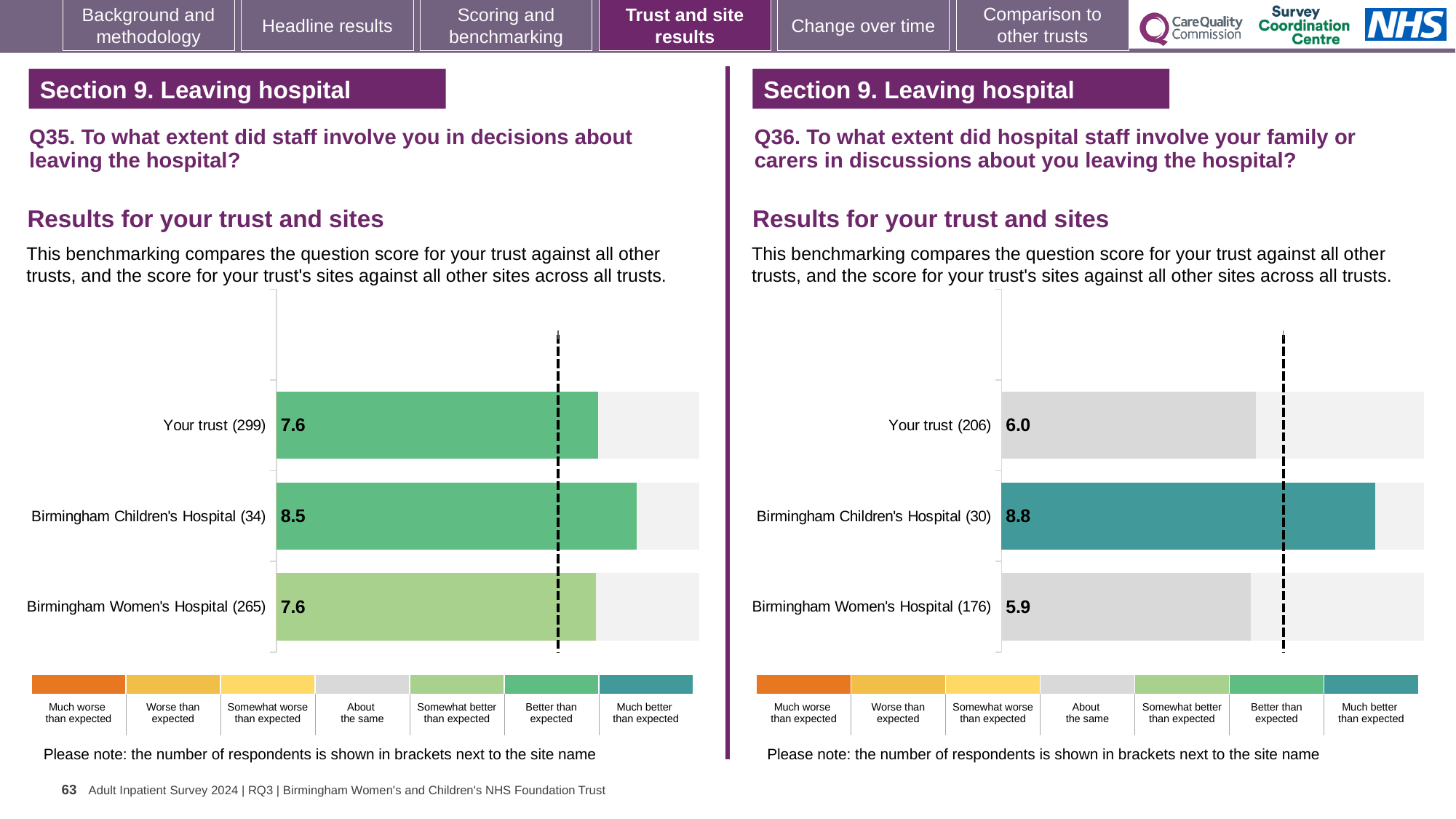
In the Q35 chart on the left, what is the score for Your trust (299)? 7.6 In the Q35 chart on the left, what is the score for Birmingham Children's Hospital (34)? 8.5 In the Q35 chart on the left, which category has the highest score? Birmingham Children's Hospital (34) How many categories (bars) are shown in the Q35 chart on the left? 3 In the Q36 chart on the right, which category has the lowest score? Birmingham Women's Hospital (176) In the Q36 chart on the right, what is the score for Your trust (206)? 6.0 In the Q36 chart on the right, what is the difference between the scores for Birmingham Children's Hospital (30) and Your trust (206)? 2.8 In the Q36 chart on the right, which benchmark category does the colour of the Birmingham Children's Hospital (30) bar correspond to in the legend? Much better than expected In the Q35 chart on the left, what is the difference between the scores for Birmingham Children's Hospital (34) and Birmingham Women's Hospital (265)? 0.9 What kind of chart is used in the Q36 chart on the right? Bar chart In the Q36 chart on the right, what is the score for Birmingham Women's Hospital (176)? 5.9 In the Q36 chart on the right, which is larger: the score for Birmingham Children's Hospital (30) or the score for Your trust (206)? Birmingham Children's Hospital (30)